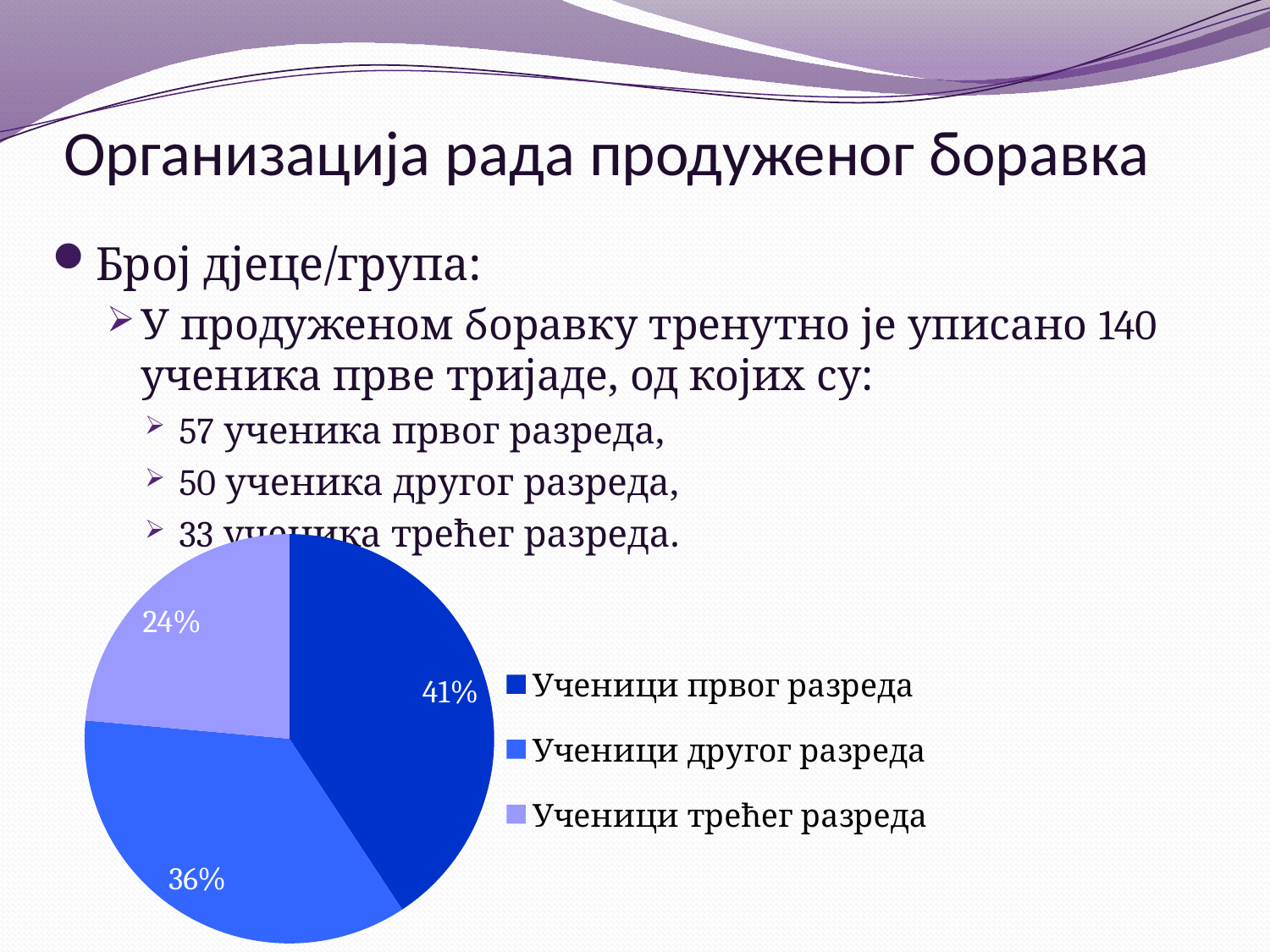
How many entries does the chart legend list? 3 How many slices does the pie chart have? 3 What type of chart is shown on the slide? Pie chart Which category has the largest slice in the pie chart? Ученици првог разреда By how many percentage points does the slice for Ученици првог разреда exceed the slice for Ученици трећег разреда? 17 percentage points Which category has the smallest slice in the pie chart? Ученици трећег разреда Which slice is larger: Ученици другог разреда or Ученици трећег разреда? Ученици другог разреда What is the difference in percentage points between the slices for Ученици другог разреда and Ученици трећег разреда? 12 percentage points Which legend entry is shown with the lightest blue colour? Ученици трећег разреда What percentage does the pie chart show for Ученици другог разреда? 36% What share of the pie chart is labelled for Ученици првог разреда? 41% What percentage does the pie chart show for Ученици трећег разреда? 24%